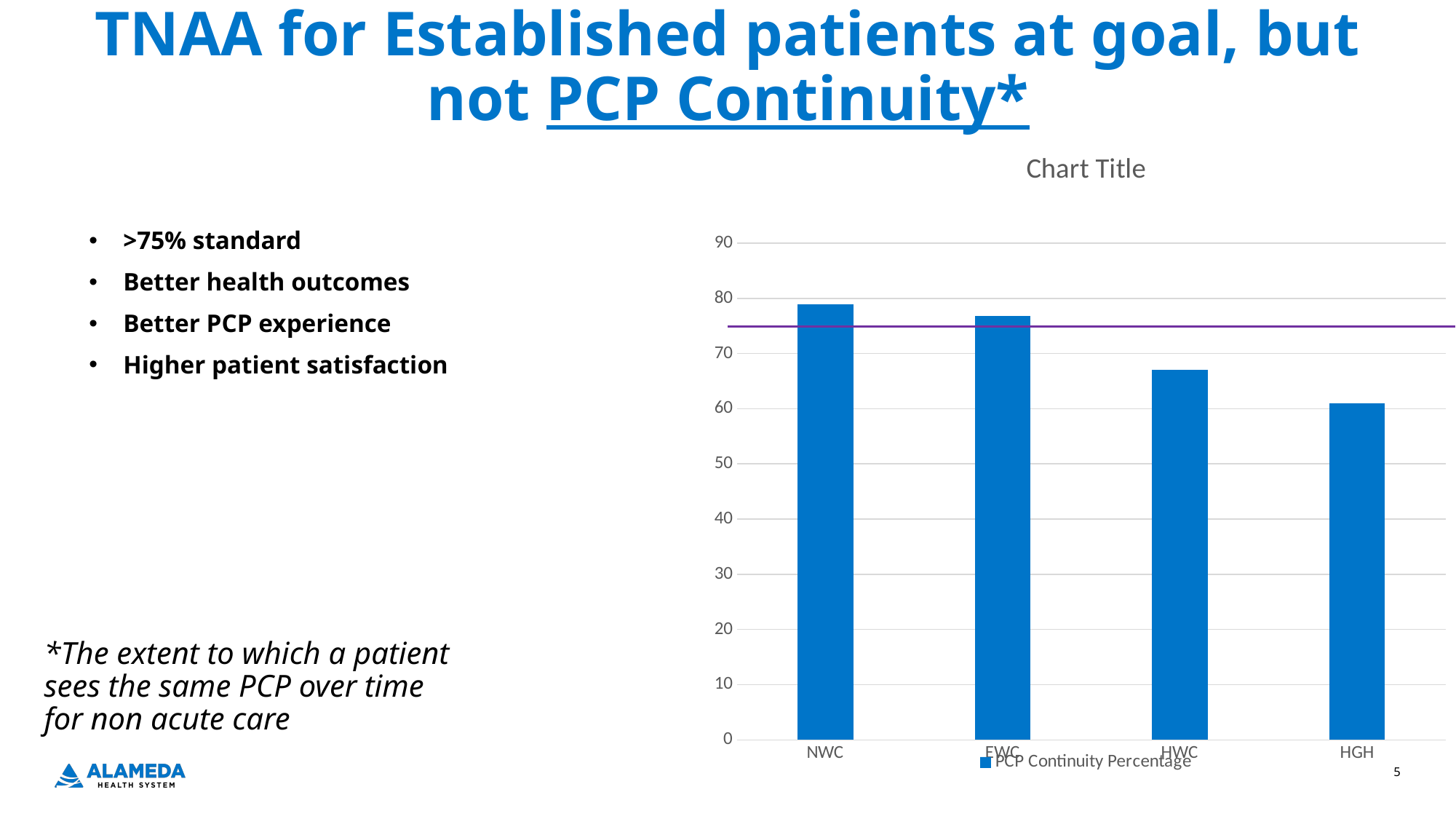
What kind of chart is shown on the slide? bar chart Do the bar values rise or fall from left to right across the x axis? fall Which category has the highest PCP Continuity Percentage? NWC Is the value for NWC greater or less than 70? greater Is the value for HWC greater or less than 60? greater Is the value for HGH greater or less than 70? less What series name is shown in the chart legend? PCP Continuity Percentage How many categories are shown on the x axis of the chart? 4 Which category has the lowest PCP Continuity Percentage? HGH Which is larger, the value for NWC or the value for HGH? NWC How many series does the chart legend list? 1